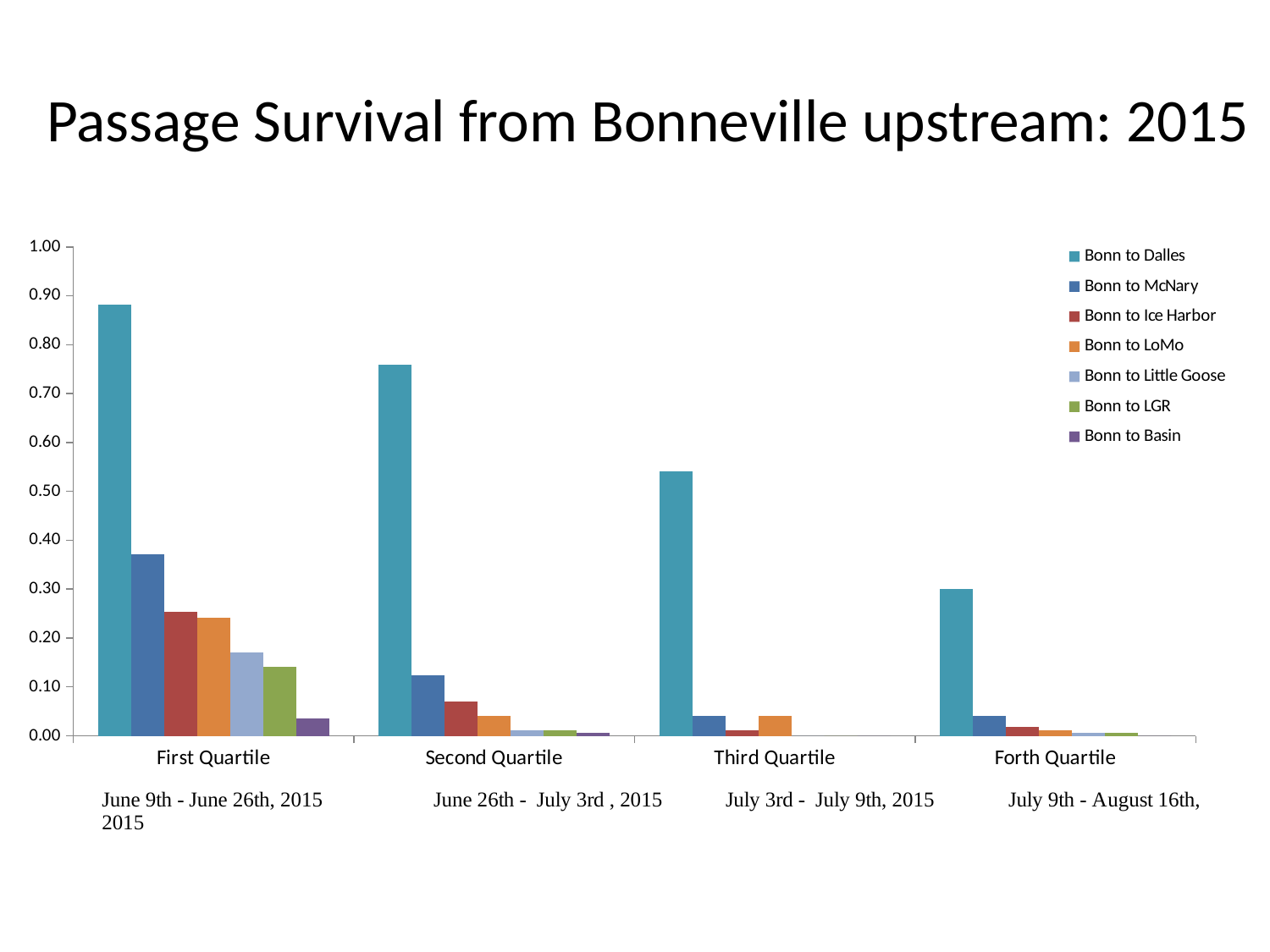
Is the value for Bonn to Dalles in the First Quartile greater or less than 0.80? greater Which quartile has the lowest value for Bonn to Dalles? Forth Quartile Is the value for Bonn to Dalles in the Third Quartile greater or less than 0.50? greater Which quartile has the highest value for Bonn to Dalles? First Quartile Is the value for Bonn to McNary in the Second Quartile greater or less than 0.20? less What is the title of the chart? Passage Survival from Bonneville upstream: 2015 What kind of chart is shown on the slide? bar chart How many series does the legend list? 7 In the First Quartile, which is larger: Bonn to McNary or Bonn to Ice Harbor? Bonn to McNary Do the Bonn to Dalles values rise or fall from the First Quartile to the Forth Quartile? fall How many quartile categories are shown on the x axis? 4